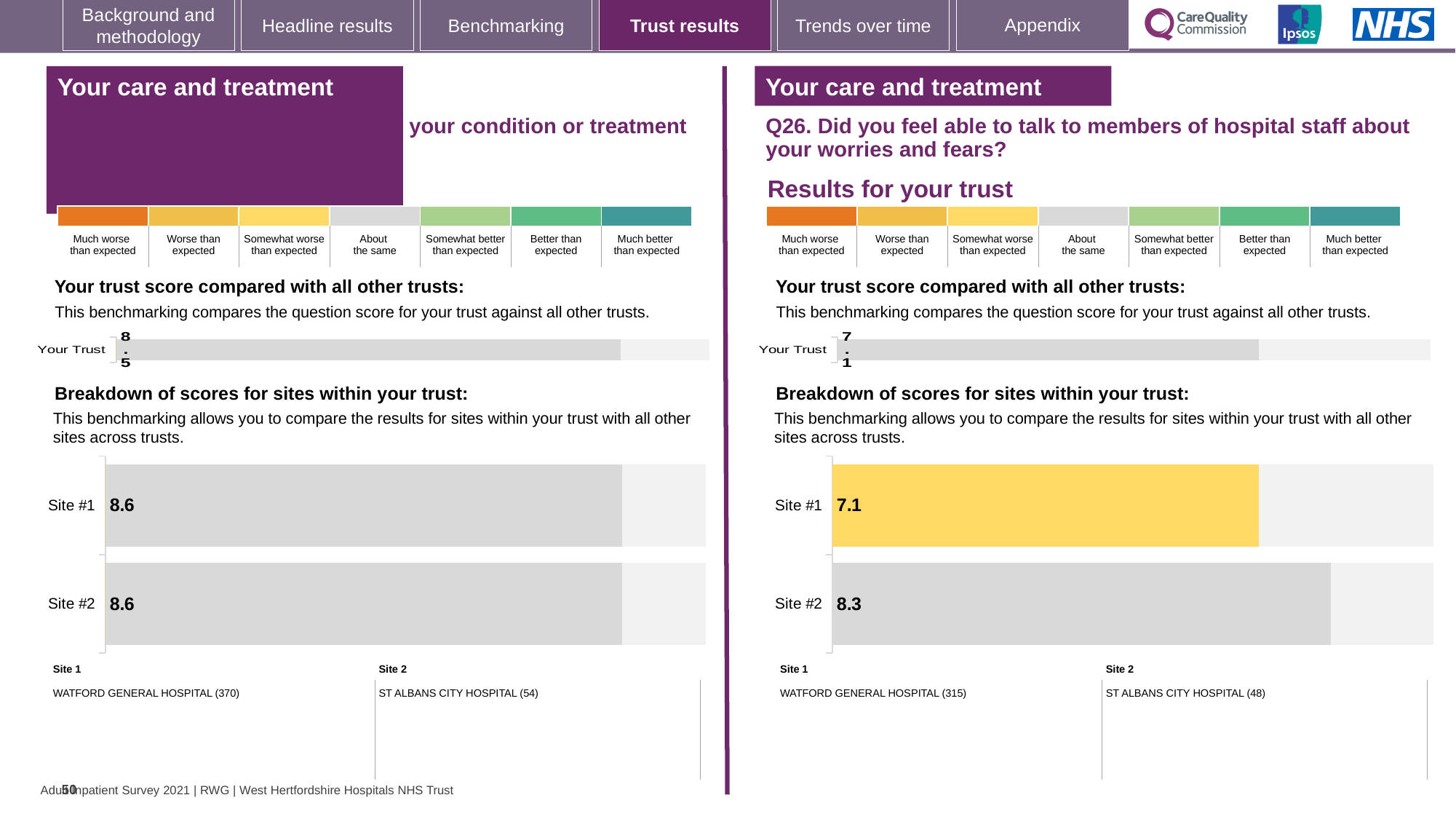
On the left-hand chart (your condition or treatment), what is the difference between the Site #1 and Site #2 scores? 0 On the right-hand chart for Q26 (worries and fears), which site has the higher score? Site #2 On the left-hand chart (your condition or treatment), what is the score for Site #1? 8.6 On the right-hand chart for Q26 (worries and fears), what is the difference between the Site #2 and Site #1 scores? 1.2 On the left-hand chart (your condition or treatment), what is the score shown for Your Trust? 8.5 What type of chart is used for the site breakdown on the right-hand side for Q26? Bar chart How many sites are shown in the site breakdown chart on the right-hand side for Q26? 2 On the right-hand chart for Q26 (worries and fears), what is the score for Site #2? 8.3 On the right-hand chart for Q26 (worries and fears), which site has the lower score? Site #1 On the right-hand chart for Q26 (worries and fears), what is the score for Site #1? 7.1 On the right-hand chart for Q26 (worries and fears), what is the score shown for Your Trust? 7.1 On the right-hand chart for Q26 (worries and fears), what colour is the Site #1 bar? Yellow